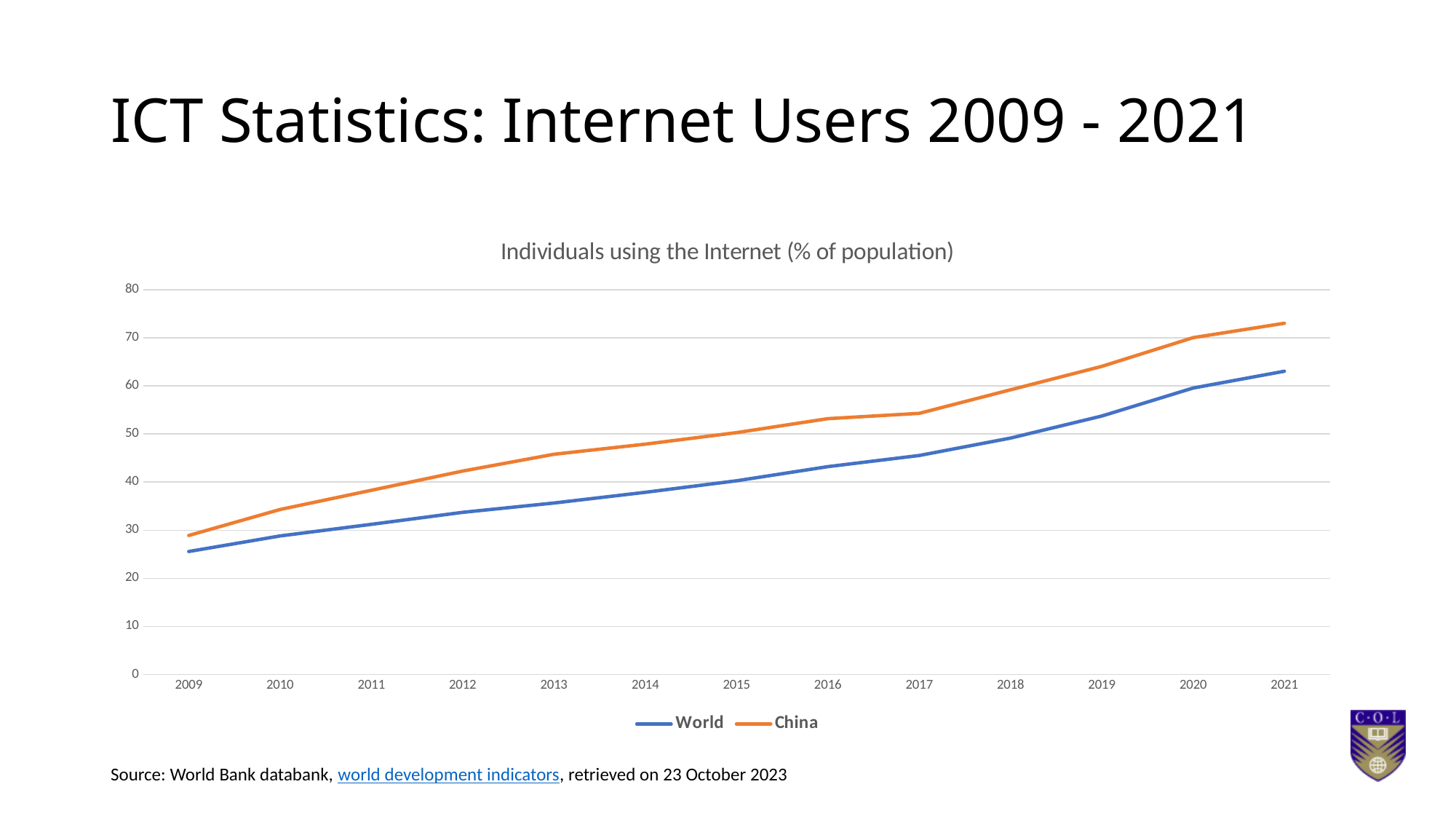
What kind of chart is shown on the slide? line chart Which series has the larger value in 2021, World or China? China What is the title of the chart? Individuals using the Internet (% of population) Is the value for China in 2013 greater or less than 40? greater How many years are plotted along the x axis? 13 Is the value for World in 2009 greater or less than 30? less Do the values for World rise or fall from 2009 to 2021? rise In which year is the value for China highest? 2021 Is the value for China in 2021 greater or less than 70? greater How many series does the legend list? 2 In which year is the value for World lowest? 2009 Which series is drawn in orange? China